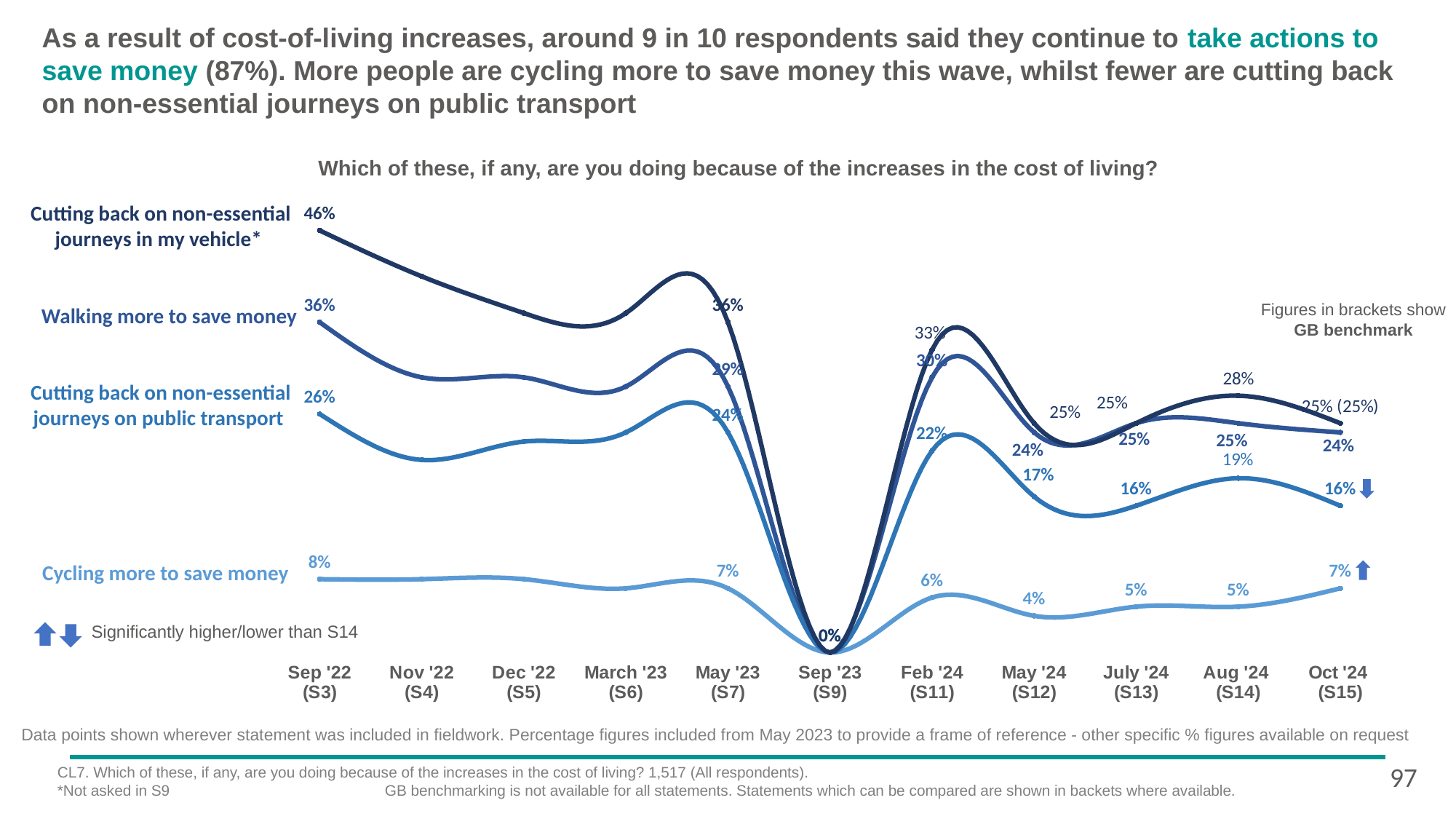
What was the value for 'Cutting back on non-essential journeys in my vehicle' in Sep '22 (S3)? 46% In Sep '22 (S3), how many percentage points higher was 'Cutting back on non-essential journeys in my vehicle' than 'Walking more to save money'? 10 percentage points Did the value for 'Cutting back on non-essential journeys on public transport' rise or fall from Sep '22 to May '24? Fall What percentage of respondents said they were cycling more to save money in Sep '22 (S3)? 8% What kind of chart is shown on the slide? Line chart Which statement had the lowest value in Oct '24 (S15)? Cycling more to save money Which is higher for 'Cycling more to save money': the Aug '24 value or the Oct '24 value? Oct '24 How many survey waves are shown along the x axis of the chart? 11 What is the GB benchmark figure shown in brackets for 'Cutting back on non-essential journeys in my vehicle' in Oct '24? 25% What was the value for 'Cutting back on non-essential journeys in my vehicle' in Aug '24 (S14)? 28% What was the value for 'Cutting back on non-essential journeys on public transport' in Oct '24 (S15)? 16% What was the value for 'Cycling more to save money' in Oct '24 (S15)? 7%